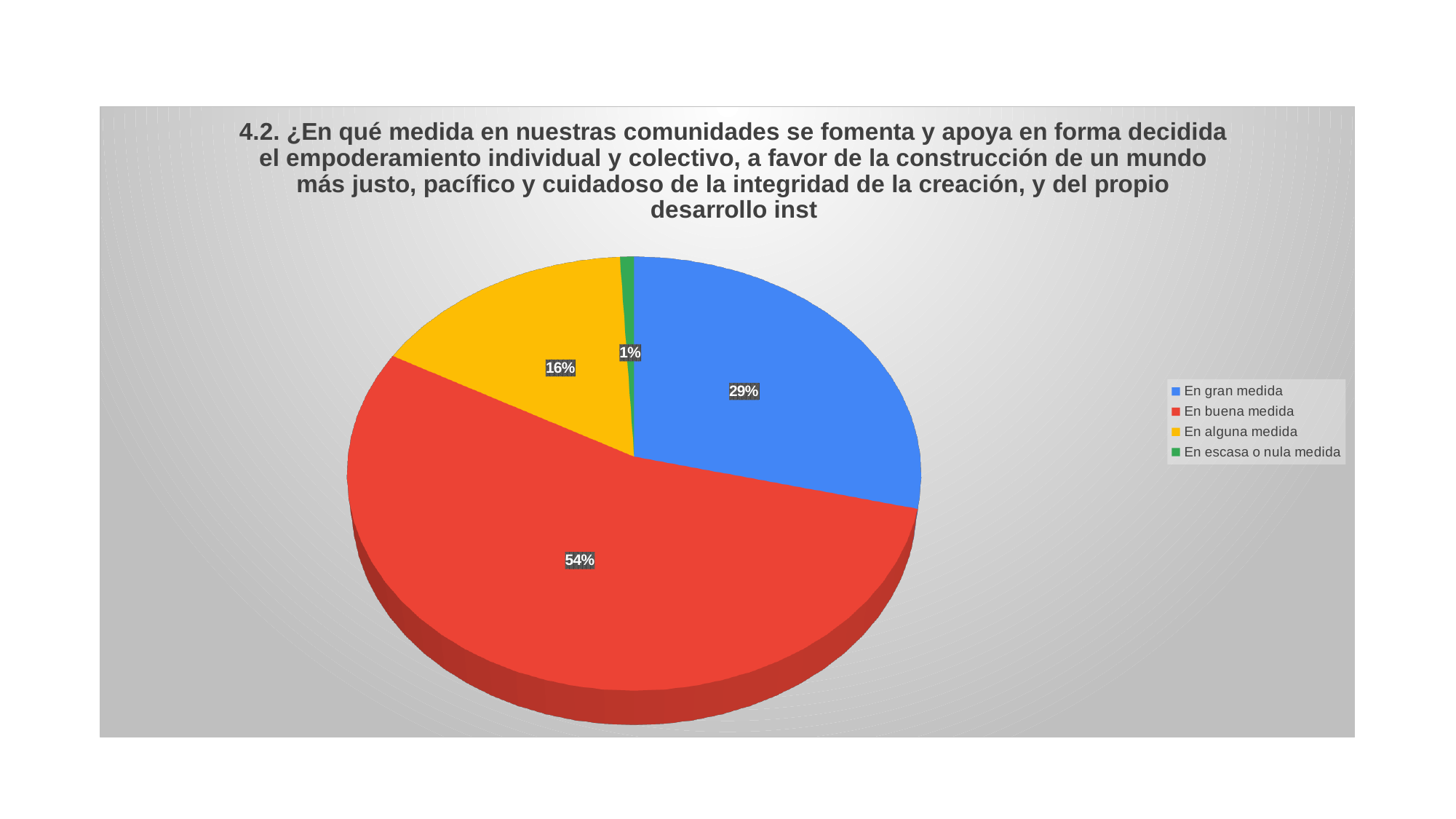
What colour is the slice for "En alguna medida"? yellow What kind of chart is shown on the slide? pie chart What share of the pie does "En buena medida" represent? 54% What is the difference in percentage points between "En buena medida" and "En gran medida"? 25 What share of the pie does "En alguna medida" represent? 16% What share of the pie does "En gran medida" represent? 29% How many categories does the legend list? 4 Which is larger, the slice for "En gran medida" or the slice for "En alguna medida"? En gran medida What is the difference in percentage points between "En alguna medida" and "En escasa o nula medida"? 15 Which category has the largest slice of the pie? En buena medida Which category has the smallest slice of the pie? En escasa o nula medida